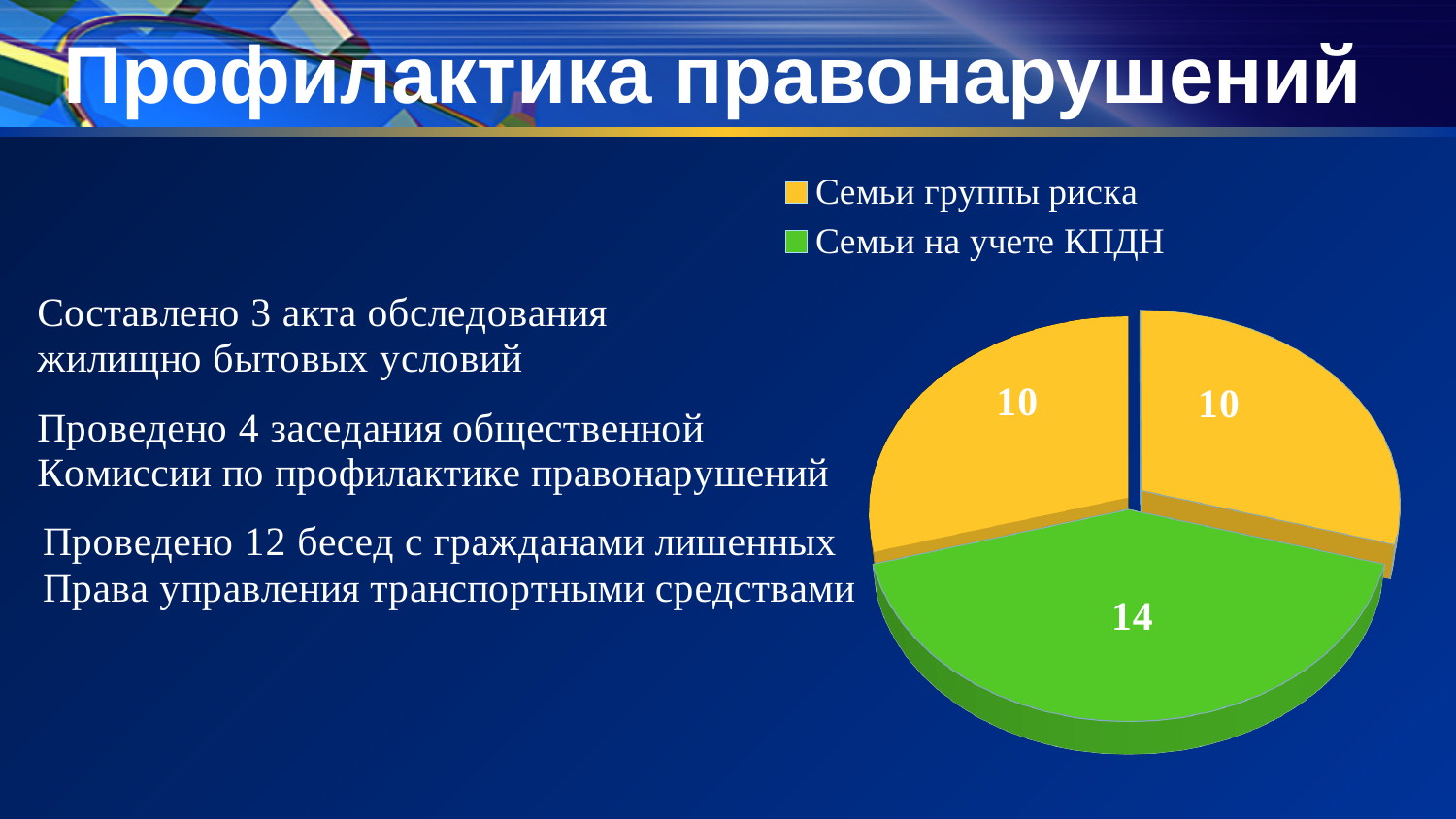
How many entries does the legend of the pie chart list? 2 What value is printed on each of the yellow slices of the pie chart? 10 Is the value of the green slice greater or less than 10? greater How many slices does the pie chart have? 3 What is the total of all the values shown on the pie chart? 34 Which is larger: the green slice or a single yellow slice? the green slice What is the second legend entry of the pie chart? Семьи на учете КПДН Which slice of the pie chart is the largest? the green slice, 14 (Семьи на учете КПДН) What value is shown on the green slice (Семьи на учете КПДН)? 14 What colour represents 'Семьи группы риска' in the legend? yellow What is the difference between the green slice value and one yellow slice value? 4 What kind of chart is shown on the slide? pie chart